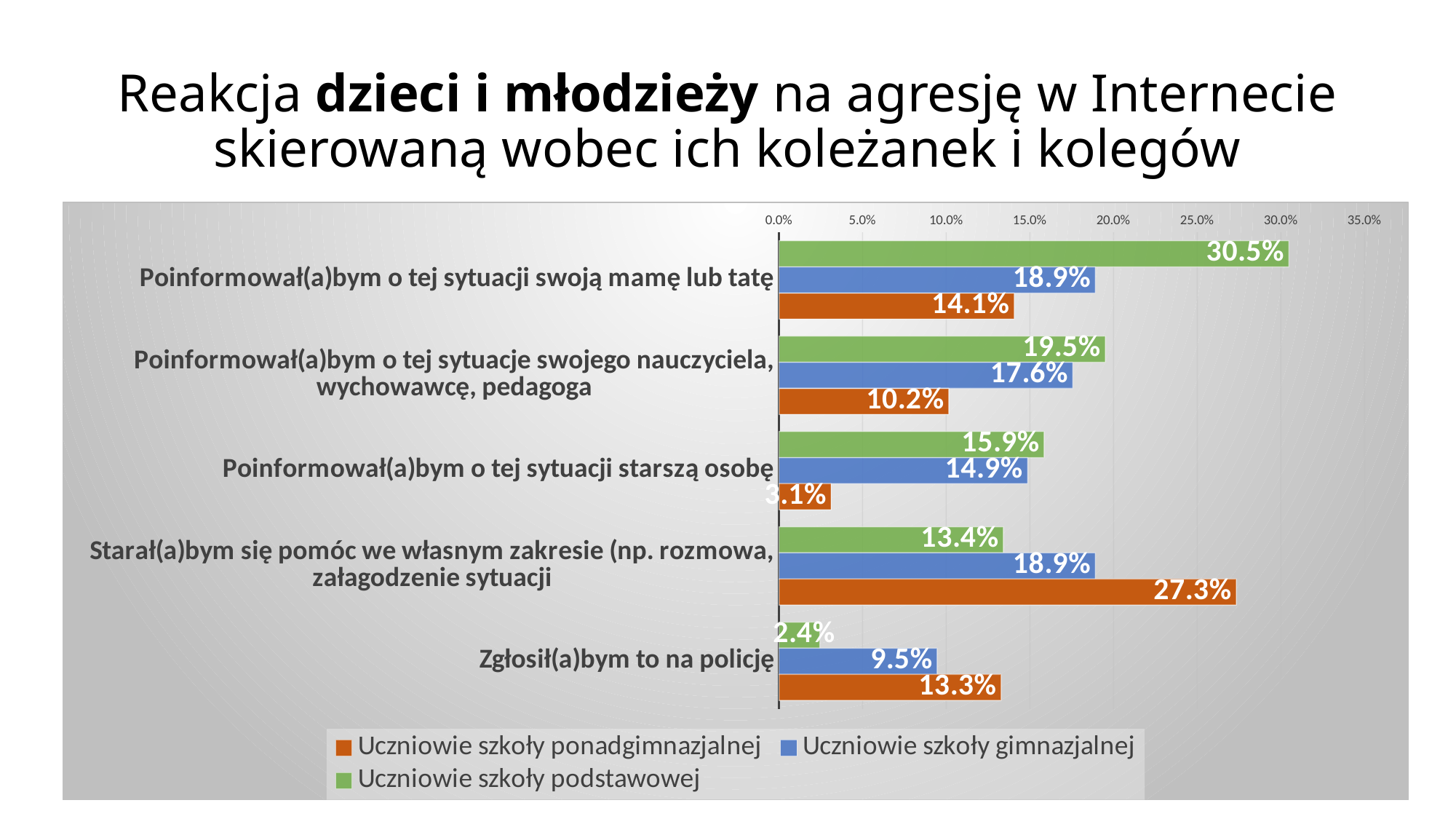
How many series does the legend list? 3 Is the value for 'Uczniowie szkoły ponadgimnazjalnej' for 'Starał(a)bym się pomóc we własnym zakresie (np. rozmowa, załagodzenie sytuacji)' greater or less than 25.0%? greater What is the value for 'Uczniowie szkoły gimnazjalnej' for 'Zgłosił(a)bym to na policję'? 9.5% Which category has the highest value for 'Uczniowie szkoły podstawowej'? Poinformował(a)bym o tej sytuacji swoją mamę lub tatę What kind of chart is shown on the slide? Bar chart Which category has the lowest value for 'Uczniowie szkoły ponadgimnazjalnej'? Poinformował(a)bym o tej sytuacji starszą osobę What is the difference between 'Uczniowie szkoły podstawowej' and 'Uczniowie szkoły ponadgimnazjalnej' for 'Poinformował(a)bym o tej sytuacji swoją mamę lub tatę'? 16.4% For 'Zgłosił(a)bym to na policję', which series has the larger value: 'Uczniowie szkoły ponadgimnazjalnej' or 'Uczniowie szkoły podstawowej'? Uczniowie szkoły ponadgimnazjalnej What is the value for 'Uczniowie szkoły ponadgimnazjalnej' for 'Starał(a)bym się pomóc we własnym zakresie (np. rozmowa, załagodzenie sytuacji)'? 27.3% What is the value for 'Uczniowie szkoły podstawowej' for 'Poinformował(a)bym o tej sytuacji swoją mamę lub tatę'? 30.5% Which colour represents 'Uczniowie szkoły gimnazjalnej' in the chart? Blue How many categories are shown on the chart? 5